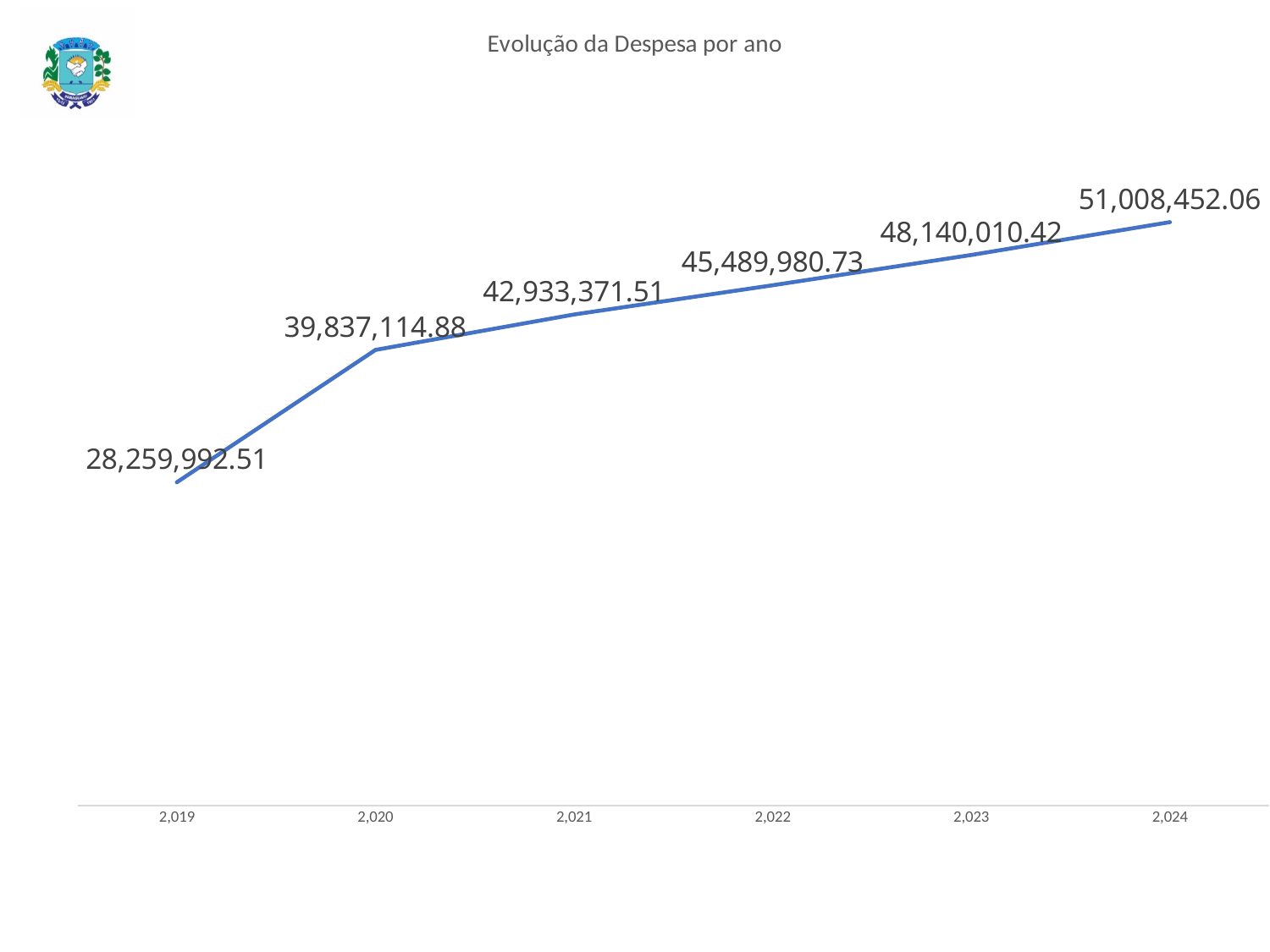
What is the title of the chart? Evolução da Despesa por ano Which is larger, the value for 2,021 or the value for 2,023? 2,023 Which year has the lowest value? 2,019 What is the value plotted for 2,020? 39,837,114.88 What type of chart is shown on the slide? line chart Do the values rise or fall from 2,019 to 2,024? rise What is the value plotted for 2,024? 51,008,452.06 How many years are plotted on the x axis? 6 What is the value plotted for 2,022? 45,489,980.73 Which year has the highest value? 2,024 What is the value plotted for 2,019? 28,259,992.51 What is the difference between the values for 2,024 and 2,023? 2,868,441.64